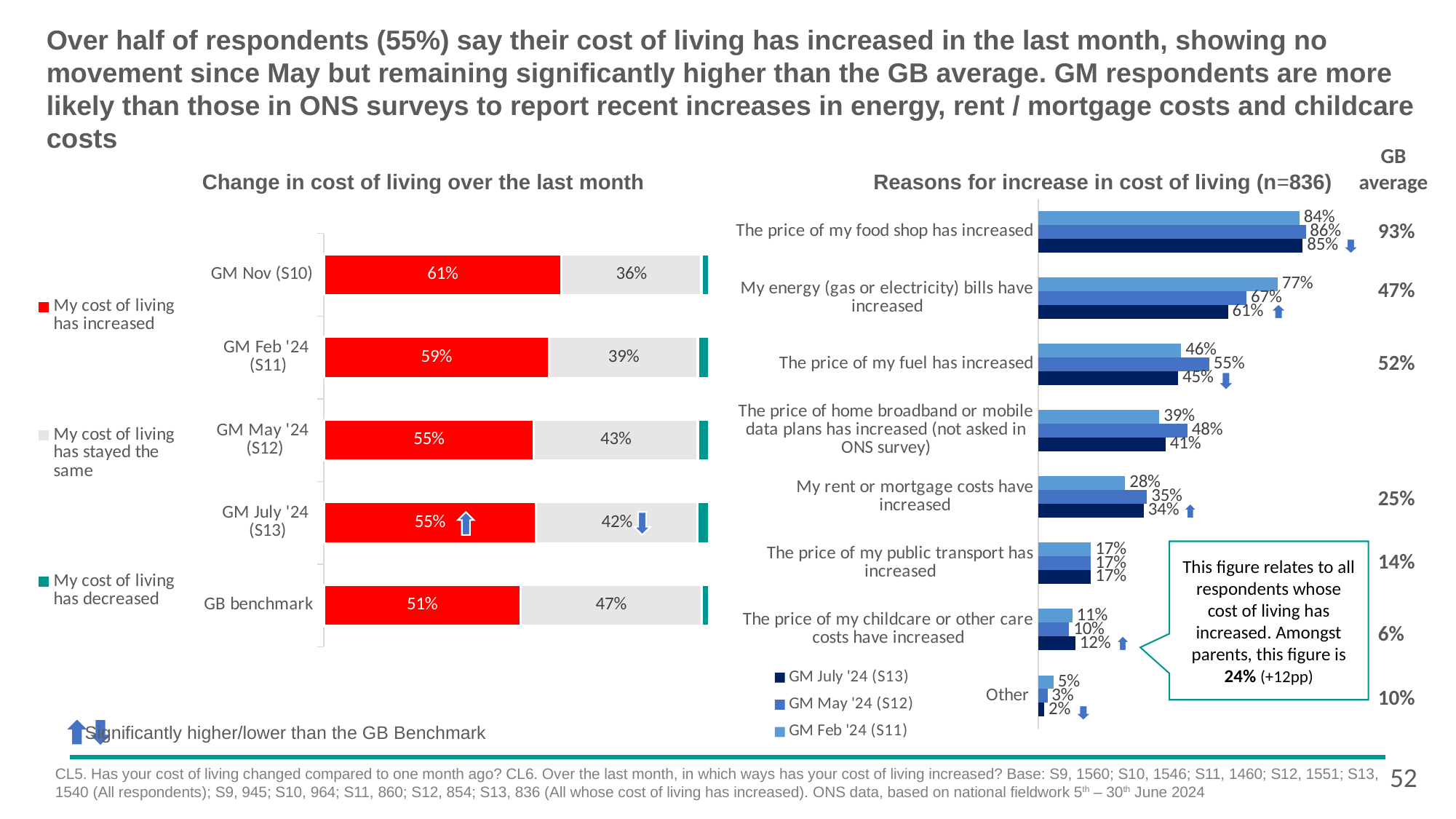
In the 'Change in cost of living over the last month' chart, how many series does the legend list? 3 In the 'Change in cost of living over the last month' chart, which category has the highest share saying their cost of living has increased? GM Nov (S10) In the 'Reasons for increase in cost of living (n=836)' chart, is the GM Feb '24 (S11) value for energy bills larger or smaller than the GM July '24 (S13) value? Larger In the 'Reasons for increase in cost of living (n=836)' chart, which reason has the lowest GM July '24 (S13) value? Other In the 'Reasons for increase in cost of living (n=836)' chart, what is the GM May '24 (S12) value for 'The price of my fuel has increased'? 55% In the 'Change in cost of living over the last month' chart, what is the difference between the 'increased' share for GM Nov (S10) and the GB benchmark? 10 percentage points In the 'Change in cost of living over the last month' chart, what percentage of GM July '24 (S13) respondents say their cost of living has increased? 55% What kind of chart is 'Change in cost of living over the last month'? Stacked bar chart In the 'Change in cost of living over the last month' chart, what percentage of the GB benchmark say their cost of living has stayed the same? 47% In the 'Reasons for increase in cost of living (n=836)' chart, what is the GM July '24 (S13) value for 'My energy (gas or electricity) bills have increased'? 61% In the 'Reasons for increase in cost of living (n=836)' chart, how many reason categories are shown? 8 In the 'Reasons for increase in cost of living (n=836)' chart, which reason has the highest GM July '24 (S13) value? The price of my food shop has increased